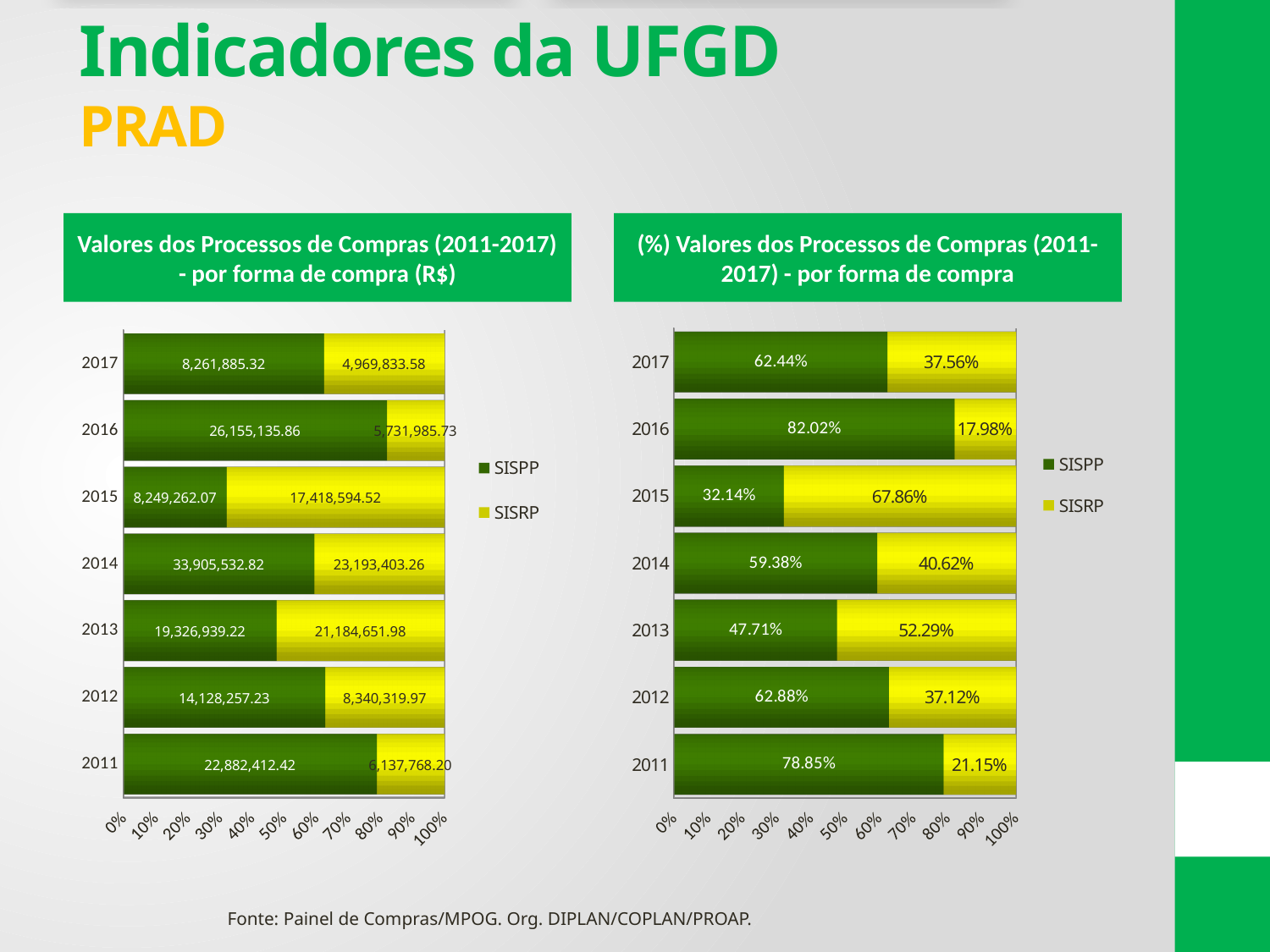
In the left chart (Valores dos Processos de Compras, R$), what is the SISRP value for 2015? 17,418,594.52 How many years are shown in the left chart (Valores dos Processos de Compras, R$)? 7 In the left chart (Valores dos Processos de Compras, R$), which year has the highest SISRP value? 2014 In the left chart (Valores dos Processos de Compras, R$), which is larger for 2013: the SISPP value or the SISRP value? SISRP In the right chart ((%) Valores dos Processos de Compras), what is the difference between the SISPP and SISRP percentages for 2017? 24.88% In the right chart ((%) Valores dos Processos de Compras), which year has the highest SISPP percentage? 2016 In the right chart ((%) Valores dos Processos de Compras), what is the SISPP percentage for 2016? 82.02% What type of chart is the left chart (Valores dos Processos de Compras, R$)? Stacked bar chart In the left chart (Valores dos Processos de Compras, R$), what is the SISPP value for 2014? 33,905,532.82 In the right chart ((%) Valores dos Processos de Compras), what is the SISRP percentage for 2013? 52.29% In the right chart ((%) Valores dos Processos de Compras), which year has the lowest SISPP percentage? 2015 How many series does the legend of the right chart ((%) Valores dos Processos de Compras) list? 2